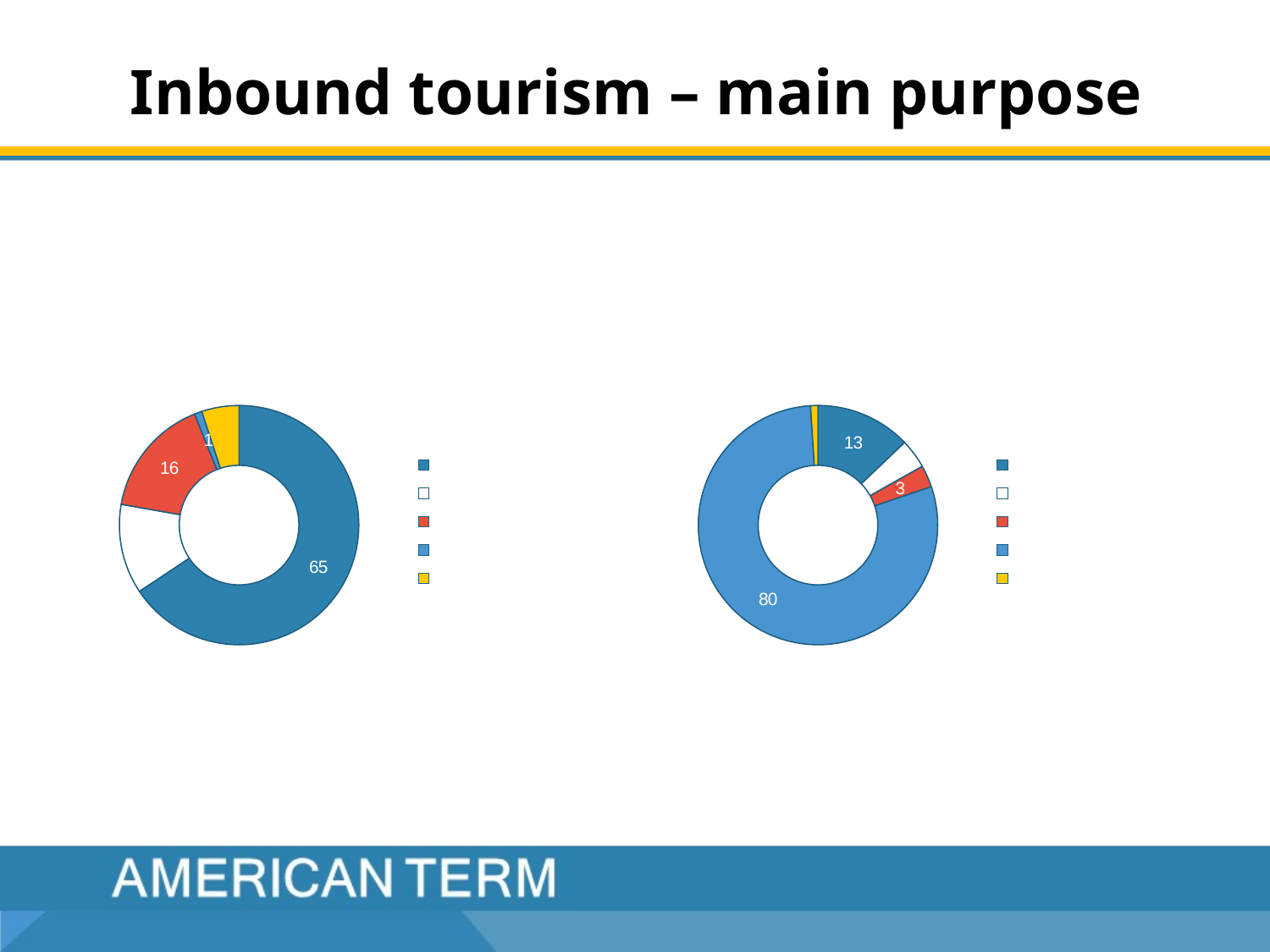
In the right chart, what is the value of the red slice? 3 In the right chart, what is the difference between the largest slice (80) and the dark blue slice (13)? 67 In the left chart, what is the value of the largest slice? 65 Which red slice has the larger value, the one in the left chart or the one in the right chart? the left chart In the left chart, what is the value of the red slice? 16 How many charts are shown on the slide? 2 Which chart has the larger value for its biggest slice, the left chart (65) or the right chart (80)? the right chart In the right chart, what is the value of the dark blue slice labelled at the top? 13 How many entries does the legend of the left chart list? 5 In the left chart, what is the difference between the largest slice (65) and the red slice (16)? 49 In the right chart, what is the value of the largest slice? 80 What kind of chart is the left chart on the slide? doughnut chart